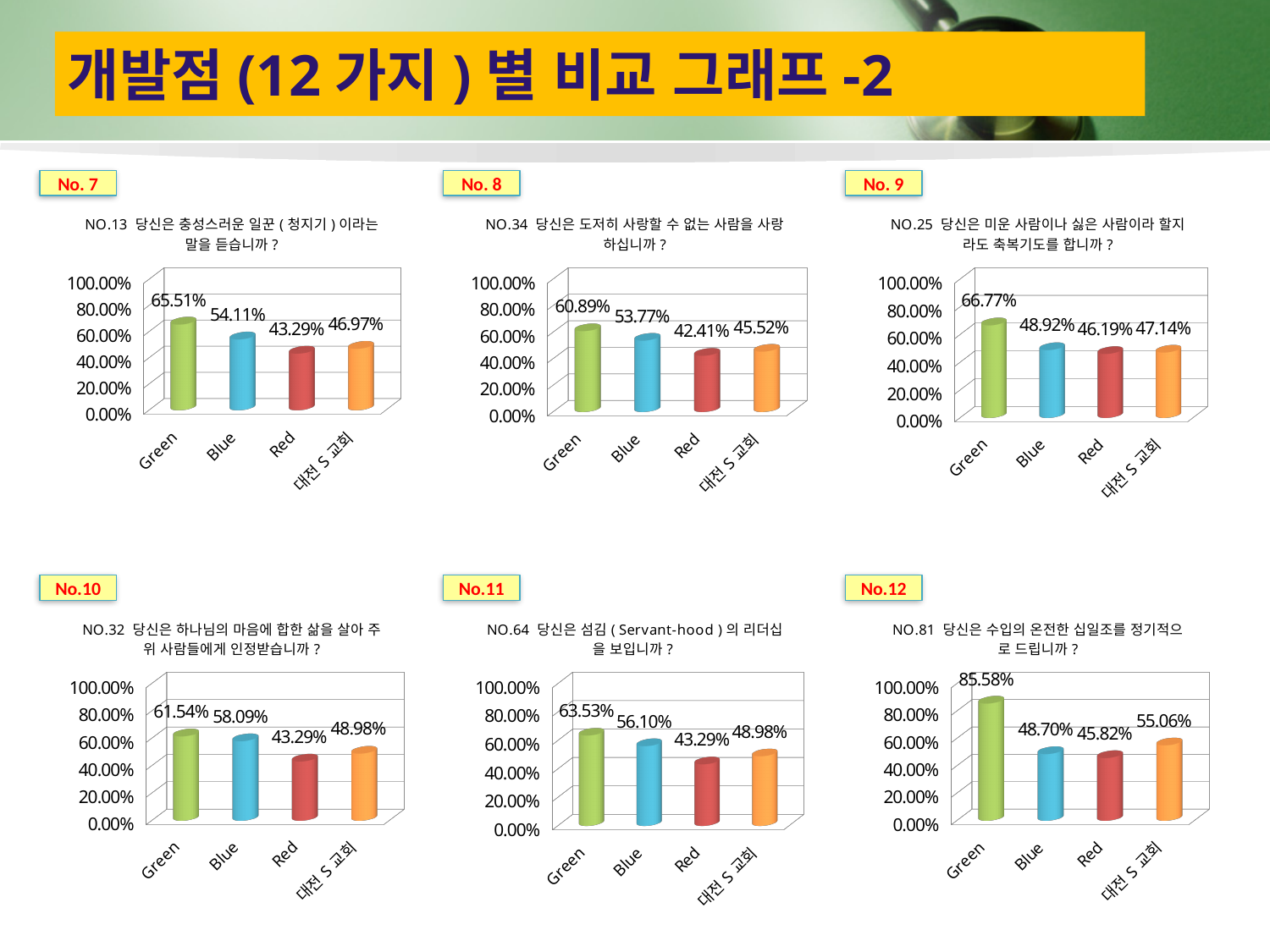
How many categories are shown on the x axis of the No. 7 chart (NO.13)? 4 In the No. 9 chart (NO.25), which category has the highest value? Green In the No.10 chart (NO.32), what is the value for Blue? 58.09% In the No.10 chart (NO.32), which category has the lowest value? Red What kind of chart is the No. 8 chart (NO.34)? Bar chart In the No.12 chart (NO.81), is the value for Green greater or less than 80.00%? greater In the No.11 chart (NO.64), which is larger, the value for Blue or the value for 대전 S 교회? Blue In the No.12 chart (NO.81), what is the difference between the Green value and the Red value? 39.76 percentage points How many charts are shown on the slide? 6 In the No. 7 chart (NO.13), what is the difference between the Green value and the Blue value? 11.40 percentage points In the No. 8 chart (NO.34), what is the value for 대전 S 교회? 45.52% In the No. 7 chart (NO.13), what is the value for Green? 65.51%